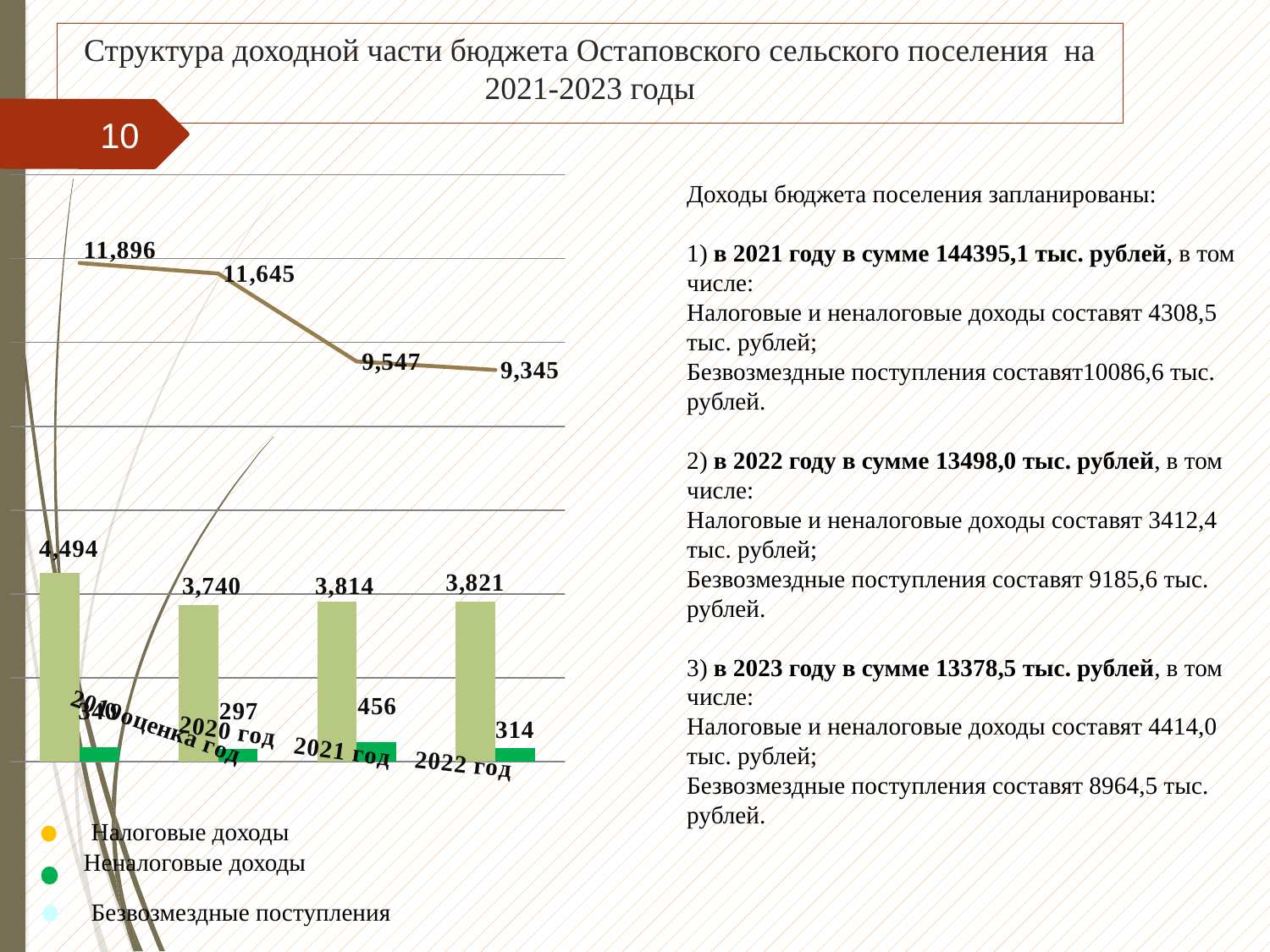
What is the value of the dark green bar for 2021 год? 456 What value does the line show for 2021 год? 9,547 What is the value of the light green bar for 2022 год? 3,821 Does the line rise or fall from left to right across the categories? Falls Which is larger, the dark green bar for 2021 год or for 2022 год? 2021 год What value does the line show for 2022 год? 9,345 What is the lowest value labelled on the line? 9,345 How many series does the legend list? 3 What is the highest value labelled on the line? 11,896 What is the difference between the dark green bar values for 2021 год and 2020 год? 159 What is the value of the dark green bar for 2020 год? 297 What is the difference between the first two values on the line, 11,896 and 11,645? 251